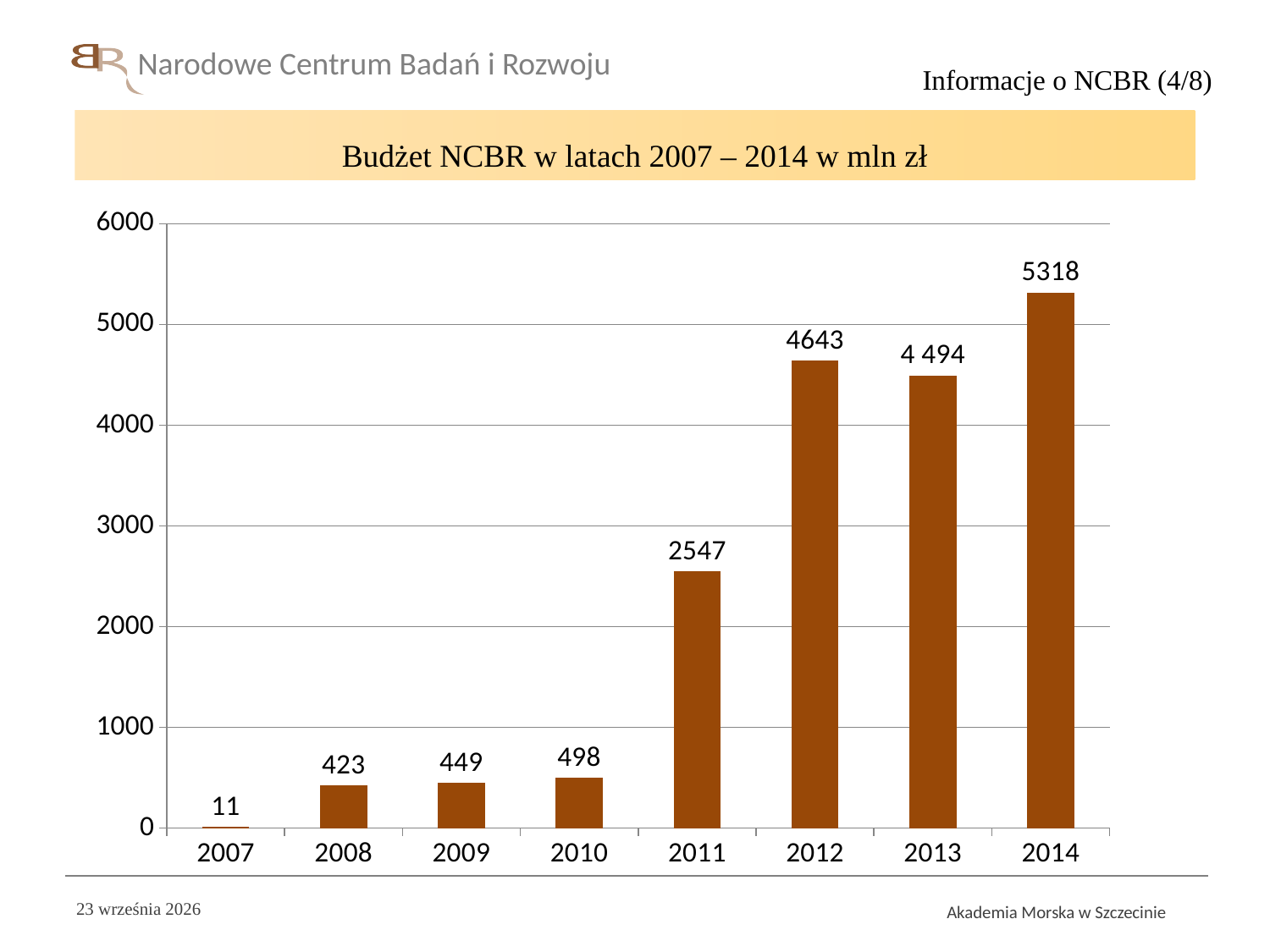
Which year has the lowest budget value? 2007 What is the difference between the values for 2014 and 2012? 675 What kind of chart is shown on the slide? bar chart How many years are shown on the x axis? 8 Which is larger, the value for 2012 or the value for 2013? 2012 Which year has the highest budget value? 2014 Is the value for 2011 greater or less than 3000? less What is the title of the chart? Budżet NCBR w latach 2007 – 2014 w mln zł What is the difference between the values for 2010 and 2008? 75 What is the NCBR budget value shown for 2011? 2547 What is the value shown for 2007? 11 What is the value shown for 2013? 4 494